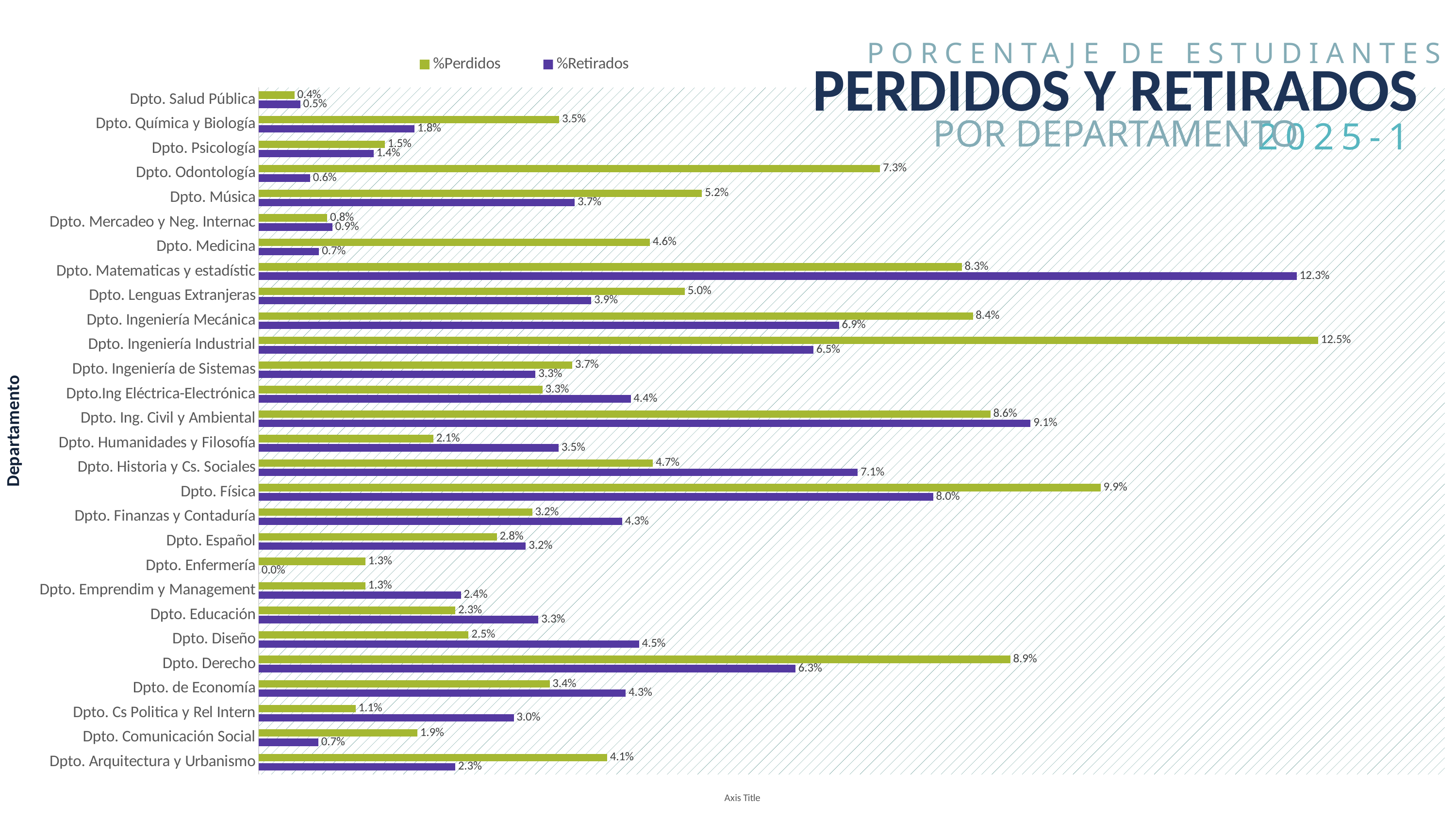
How many departments are shown on the chart? 28 Which department has the lowest %Perdidos value? Dpto. Salud Pública What is the %Perdidos value for Dpto. Odontología? 7.3% Which department has the highest %Perdidos value? Dpto. Ingeniería Industrial What is the difference between the %Perdidos and %Retirados values for Dpto. Derecho? 2.6% Which department has the lowest %Retirados value? Dpto. Enfermería For Dpto. Historia y Cs. Sociales, which is larger: %Perdidos or %Retirados? %Retirados Which colour represents the %Retirados series in the chart? Purple What is the %Retirados value for Dpto. Física? 8.0% What kind of chart is shown on the slide? Bar chart Which department has the highest %Retirados value? Dpto. Matematicas y estadístic How many series does the legend list? 2